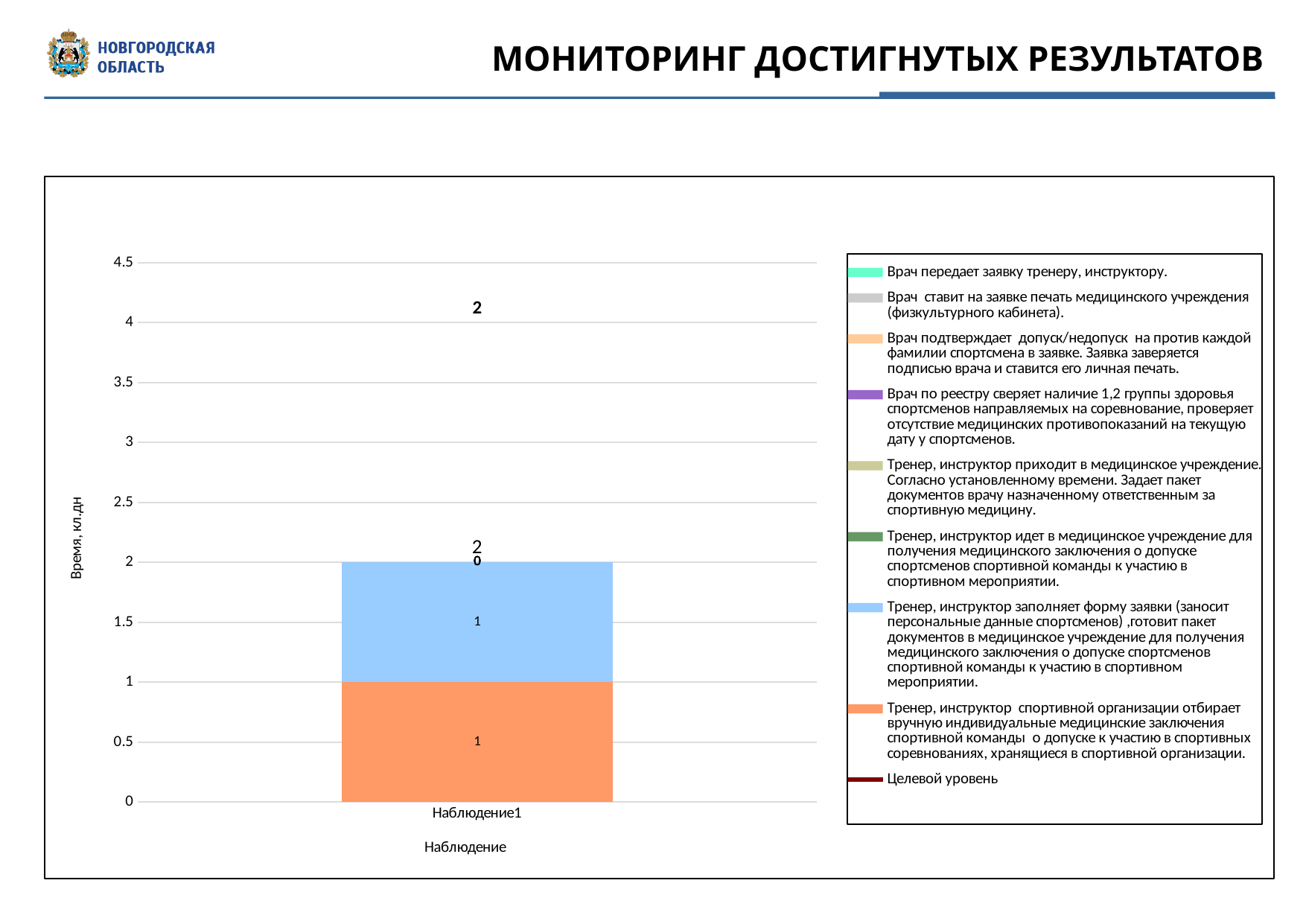
Is the total of the stacked bar for Наблюдение1 greater or less than 3? less What is the highest value shown on the vertical axis? 4.5 How many entries does the legend list? 9 What is the label of the single category on the x axis? Наблюдение1 How many categories are plotted on the x axis? 1 What is the title of the vertical axis? Время, кл.дн What is the value of the light blue segment (Тренер, инструктор заполняет форму заявки...) for Наблюдение1? 1 What is the total height of the stacked bar for Наблюдение1? 2 What is the value of the orange segment (Тренер, инструктор спортивной организации отбирает вручную индивидуальные медицинские заключения...) for Наблюдение1? 1 What kind of chart is shown on the slide? Stacked bar chart